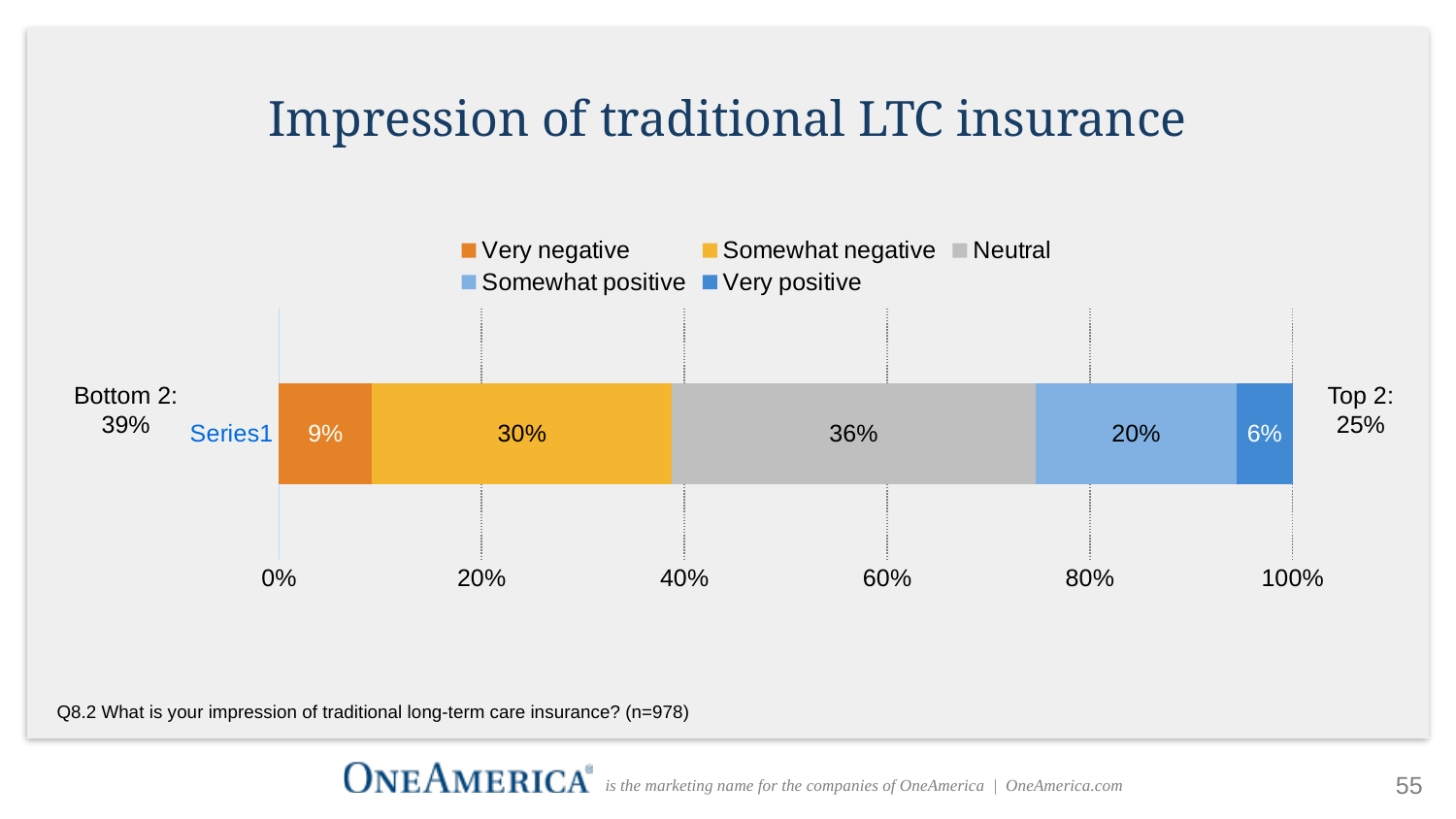
What percentage of respondents are neutral about traditional LTC insurance? 36% Which response category has the smallest share of respondents? Very positive What is the title of the chart? Impression of traditional LTC insurance What kind of chart is shown on the slide? Stacked bar chart What percentage of respondents have a very negative impression of traditional LTC insurance? 9% What percentage of respondents have a very positive impression? 6% What is the difference between the somewhat negative and somewhat positive percentages? 10% How many series does the legend list? 5 What percentage of respondents have a somewhat positive impression? 20% What is the combined Bottom 2 percentage shown on the slide? 39% Which is larger, the somewhat negative share or the neutral share? Neutral Which response category has the largest share of respondents? Neutral